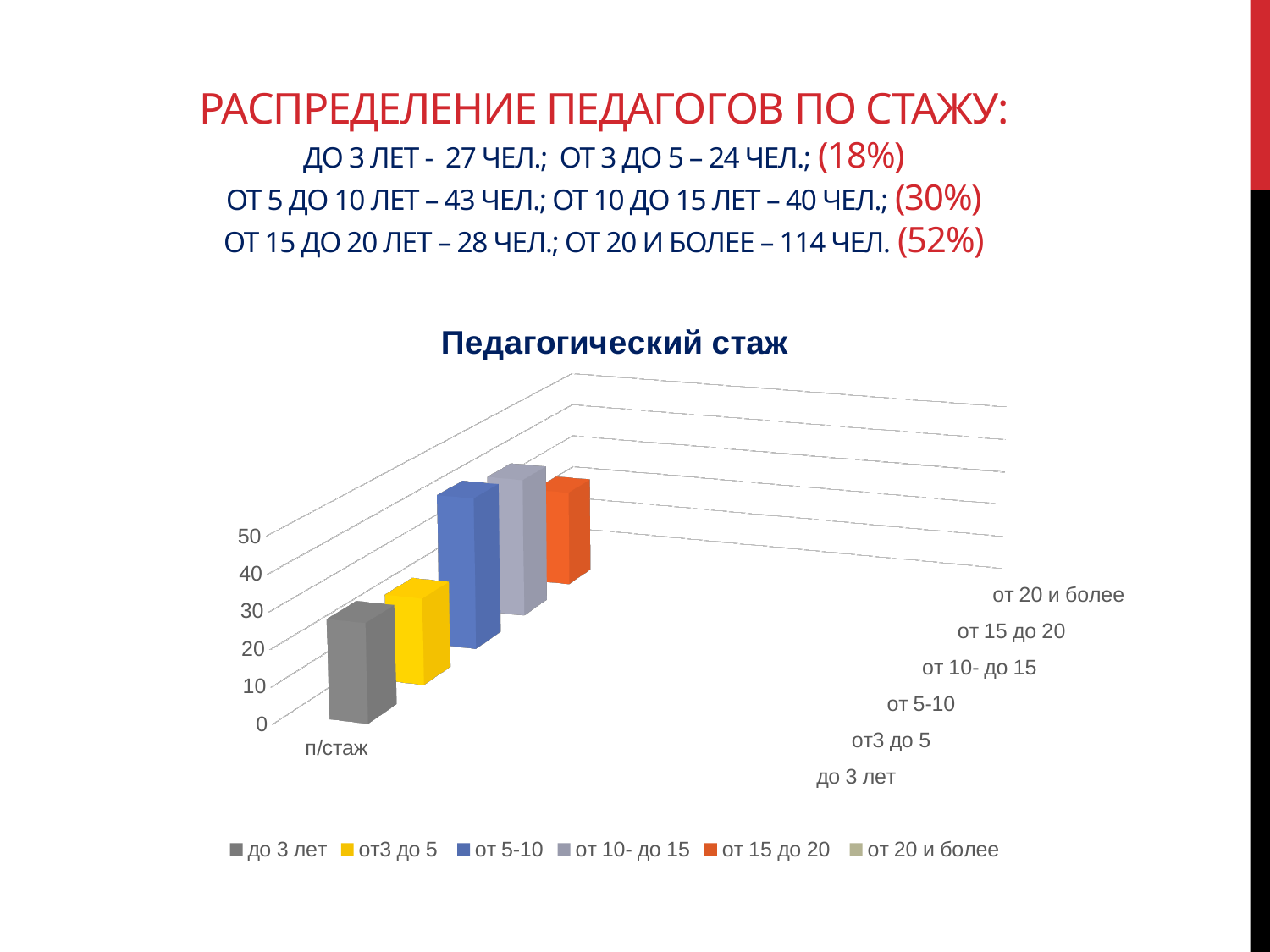
What label is shown on the horizontal category axis of the chart? п/стаж What kind of chart is shown on the slide? bar chart Which is larger in the chart, the bar for от 10- до 15 or the bar for до 3 лет? от 10- до 15 Is the value for от3 до 5 greater or less than 50? less Which is larger in the chart, the bar for от 5-10 or the bar for от3 до 5? от 5-10 What is the title of the chart? Педагогический стаж Is the value for от 10- до 15 greater or less than 20? greater Is the value for от 5-10 greater or less than 20? greater How many series does the chart legend list? 6